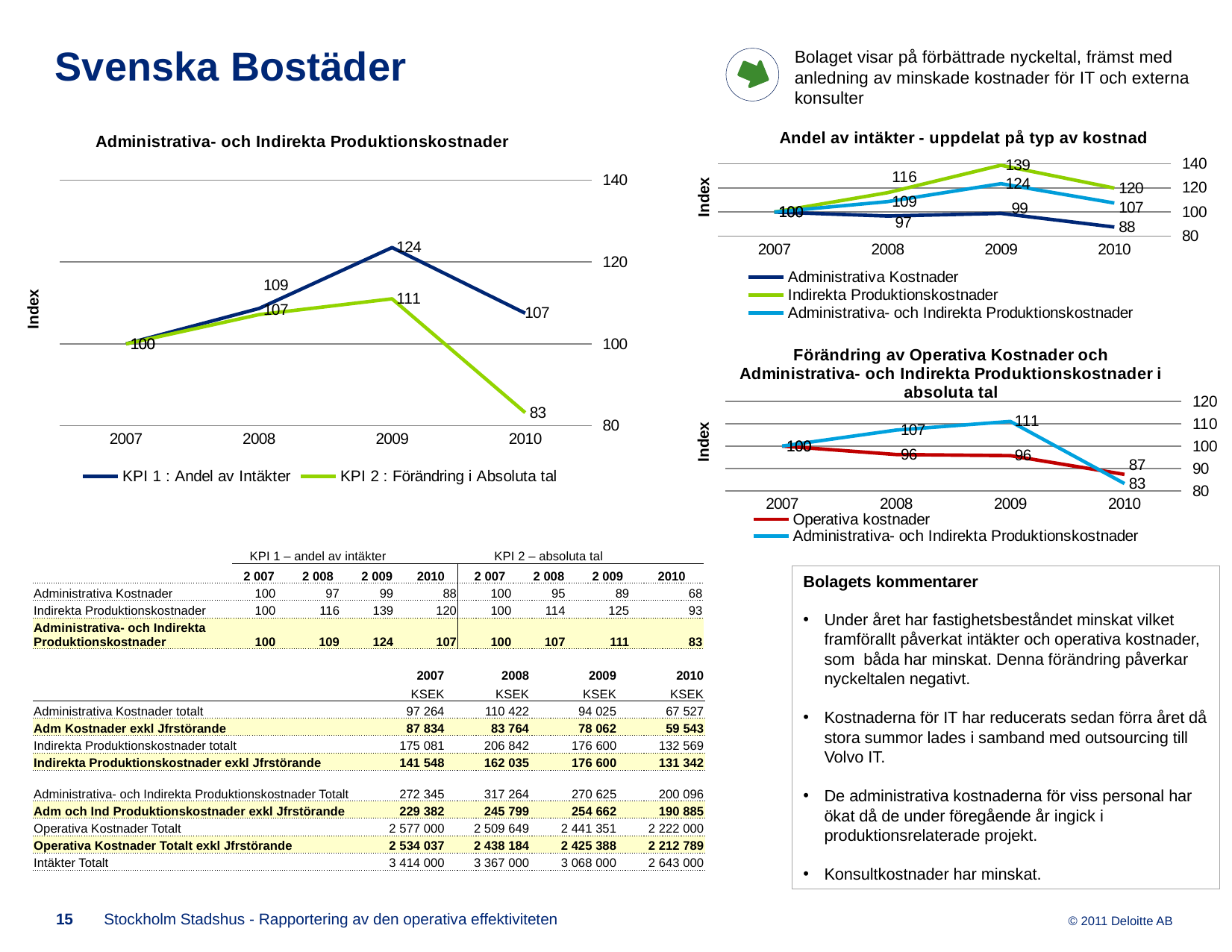
In the chart titled 'Administrativa- och Indirekta Produktionskostnader', what is the value of KPI 2 : Förändring i Absoluta tal in 2010? 83 In the chart titled 'Administrativa- och Indirekta Produktionskostnader', how many series does the legend list? 2 In the chart titled 'Administrativa- och Indirekta Produktionskostnader', what is the value of KPI 1 : Andel av Intäkter in 2009? 124 In the chart titled 'Administrativa- och Indirekta Produktionskostnader', what is the difference between KPI 1 and KPI 2 in 2010? 24 In the chart titled 'Andel av intäkter - uppdelat på typ av kostnad', which is larger in 2008: Administrativa Kostnader or Indirekta Produktionskostnader? Indirekta Produktionskostnader In the chart titled 'Andel av intäkter - uppdelat på typ av kostnad', which year has the lowest value for Administrativa Kostnader? 2010 In the chart titled 'Andel av intäkter - uppdelat på typ av kostnad', how many series does the legend list? 3 What type of chart is the chart titled 'Administrativa- och Indirekta Produktionskostnader'? Line chart In the chart titled 'Andel av intäkter - uppdelat på typ av kostnad', what is the value of Indirekta Produktionskostnader in 2009? 139 In the chart titled 'Förändring av Operativa Kostnader och Administrativa- och Indirekta Produktionskostnader i absoluta tal', what is the value of Operativa kostnader in 2010? 87 In the chart titled 'Förändring av Operativa Kostnader och Administrativa- och Indirekta Produktionskostnader i absoluta tal', how many years are shown on the x axis? 4 In the chart titled 'Förändring av Operativa Kostnader och Administrativa- och Indirekta Produktionskostnader i absoluta tal', does Operativa kostnader rise or fall from 2007 to 2010? Fall